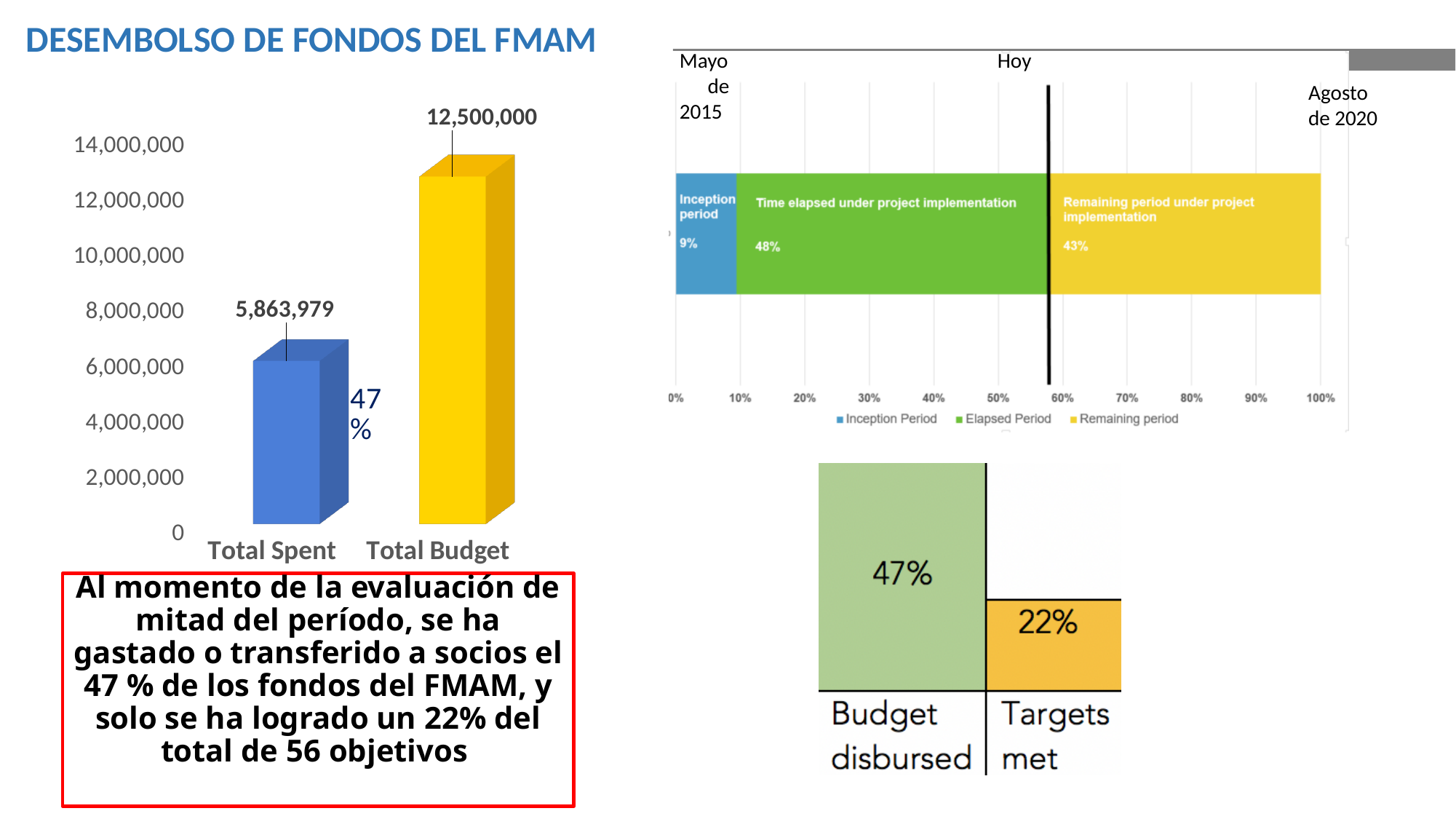
In the bar chart titled 'DESEMBOLSO DE FONDOS DEL FMAM', what is the difference between Total Budget and Total Spent? 6,636,021 In the timeline chart at the top right, what percentage is shown for the Inception period? 9% In the bar chart at the bottom right, what is the value for Budget disbursed? 47% In the bar chart titled 'DESEMBOLSO DE FONDOS DEL FMAM', which category has the higher value, Total Spent or Total Budget? Total Budget In the bar chart titled 'DESEMBOLSO DE FONDOS DEL FMAM', what is the value for Total Spent? 5,863,979 In the bar chart at the bottom right, what is the difference between Budget disbursed and Targets met? 25% In the timeline chart at the top right, how many series does the legend list? 3 In the bar chart titled 'DESEMBOLSO DE FONDOS DEL FMAM', what percentage label is shown next to the Total Spent bar? 47% In the timeline chart at the top right, what percentage is shown for the time elapsed under project implementation? 48% In the bar chart titled 'DESEMBOLSO DE FONDOS DEL FMAM', how many categories are shown? 2 In the bar chart titled 'DESEMBOLSO DE FONDOS DEL FMAM', what is the value for Total Budget? 12,500,000 In the timeline chart at the top right, what percentage is shown for the remaining period under project implementation? 43%